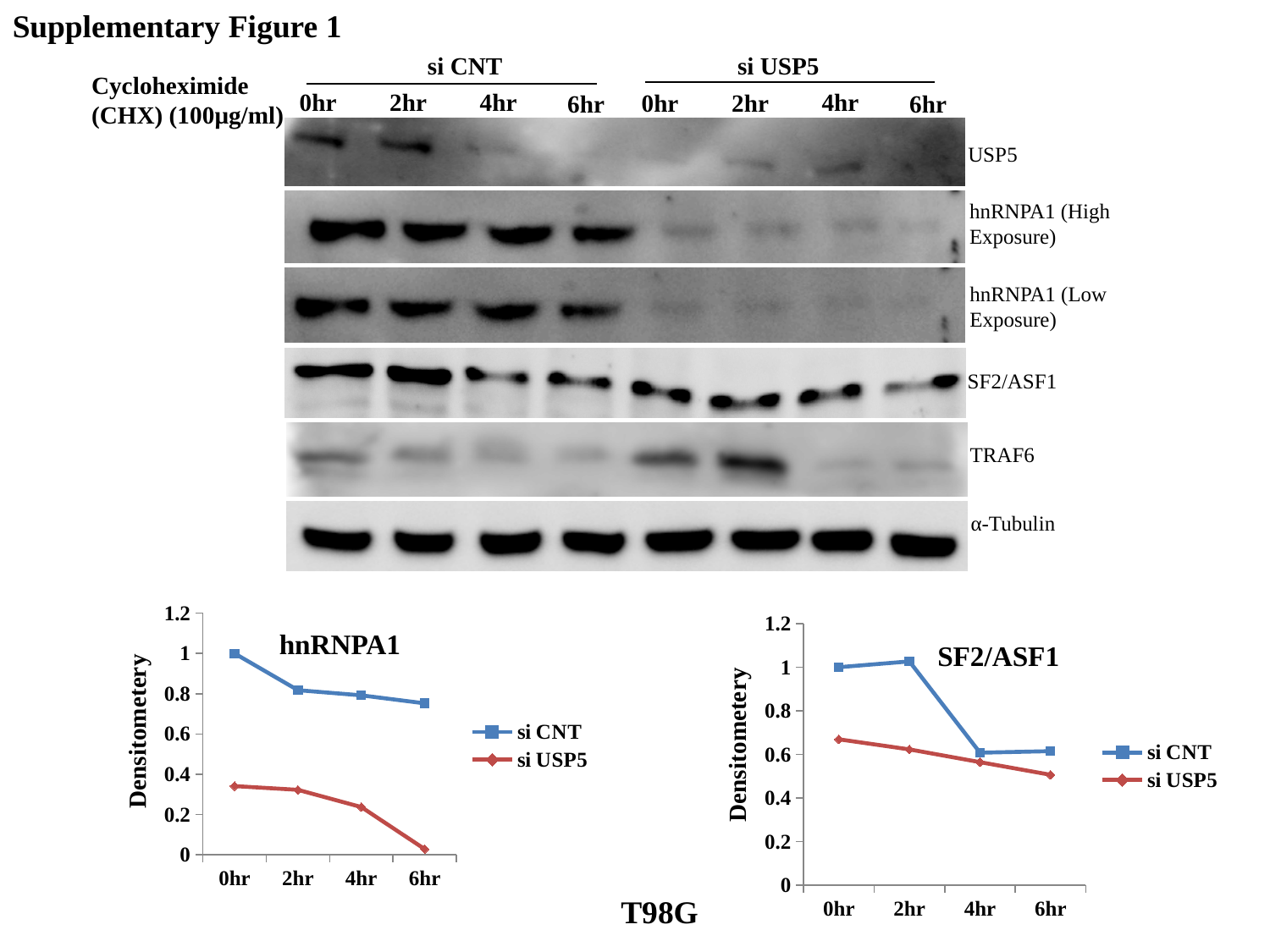
How many series does the legend of the SF2/ASF1 chart list? 2 In the SF2/ASF1 chart, which series has the larger value at 6hr, si CNT or si USP5? si CNT What kind of chart is the hnRNPA1 chart? line chart In the hnRNPA1 chart, is the si USP5 value at 6hr greater or less than 0.2? less In the hnRNPA1 chart, do the si USP5 values rise or fall from 0hr to 6hr? fall How many time points are plotted along the x axis of the hnRNPA1 chart? 4 In the SF2/ASF1 chart, is the si CNT value at 4hr greater or less than 0.8? less In the hnRNPA1 chart, which series has the larger value at 0hr, si CNT or si USP5? si CNT In the hnRNPA1 chart, is the si CNT value at 2hr greater or less than 0.6? greater In the hnRNPA1 chart, what is the si CNT value at 0hr? 1 What is the y-axis label of the SF2/ASF1 chart? Densitometery